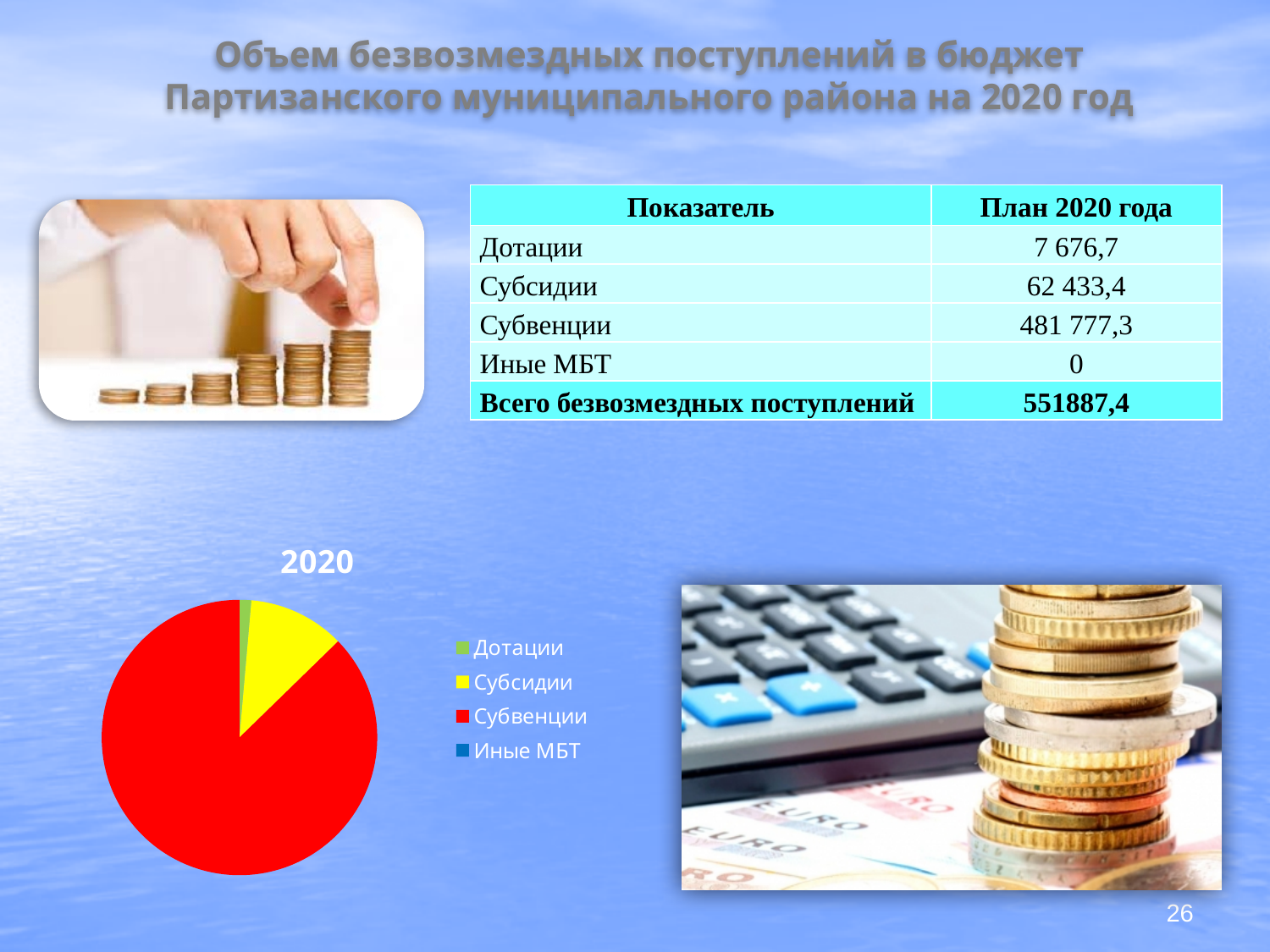
What colour is the Субвенции slice in the pie chart? red Which slice is larger in the pie chart, Субсидии or Дотации? Субсидии What is the title of the pie chart? 2020 According to the slide, what is the planned 2020 value for Субвенции? 481 777,3 How many entries does the pie chart's legend list? 4 According to the slide, what is the planned 2020 value for Иные МБТ? 0 What kind of chart is shown on the slide? pie chart Which slice is larger in the pie chart, Субвенции or Субсидии? Субвенции Which category has the smallest visible slice in the pie chart? Дотации What is the difference between the 2020 values for Субвенции and Субсидии shown on the slide? 418 943,9 According to the slide, what is the planned 2020 value for Субсидии? 62 433,4 Which category has the largest slice in the pie chart? Субвенции